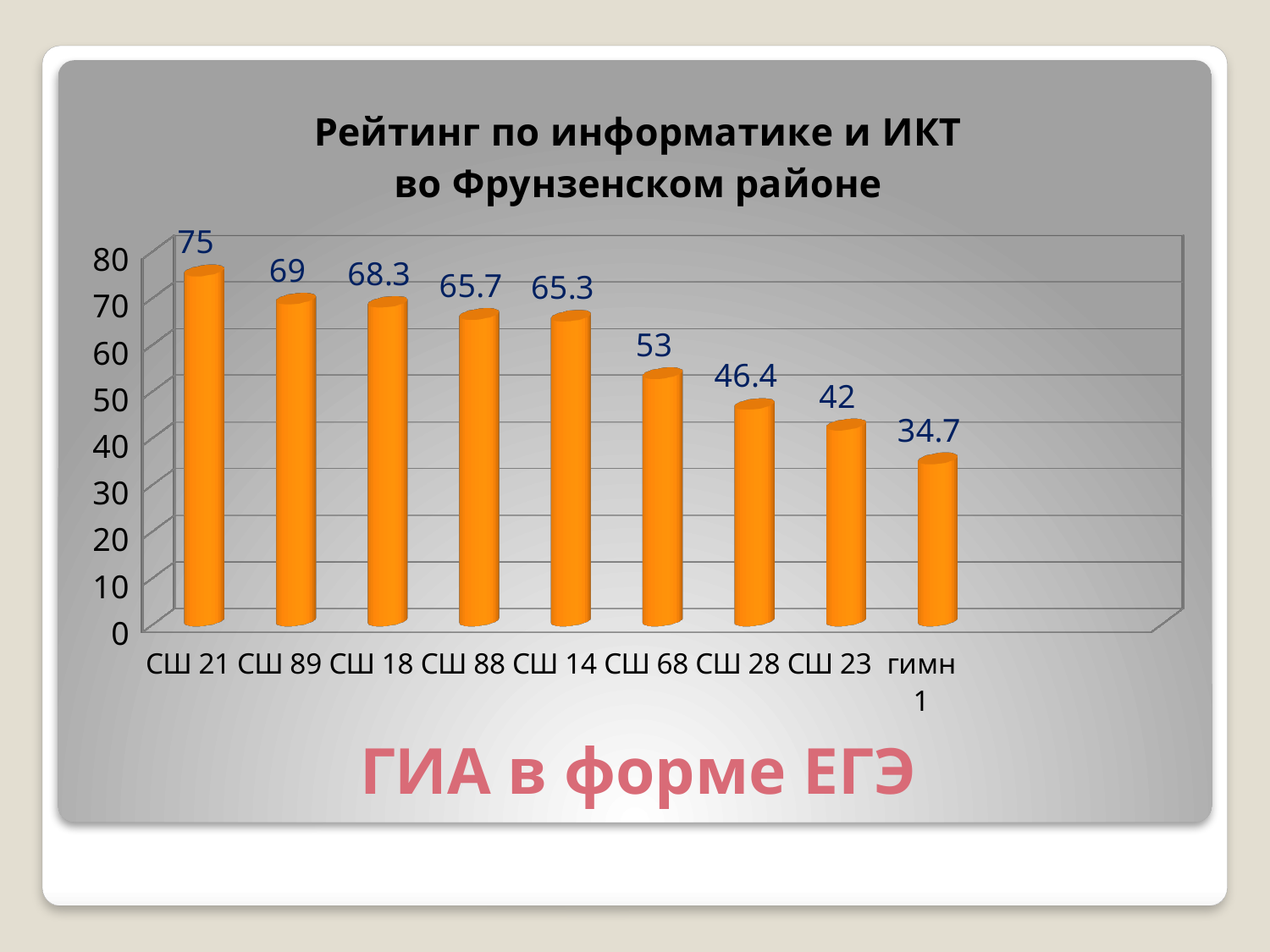
What kind of chart is this? bar chart What is the value for СШ 28? 46.4 Which category has the highest value? СШ 21 What is the difference between the values for СШ 89 and СШ 23? 27 Which is larger, the value for СШ 88 or the value for СШ 68? СШ 88 How many categories are shown on the x axis? 9 Which category has the lowest value? гимн 1 What is the value for СШ 68? 53 What is the difference between the values for СШ 21 and гимн 1? 40.3 Do the values rise or fall from left to right along the x axis? fall What is the value for СШ 21? 75 What is the value for гимн 1? 34.7